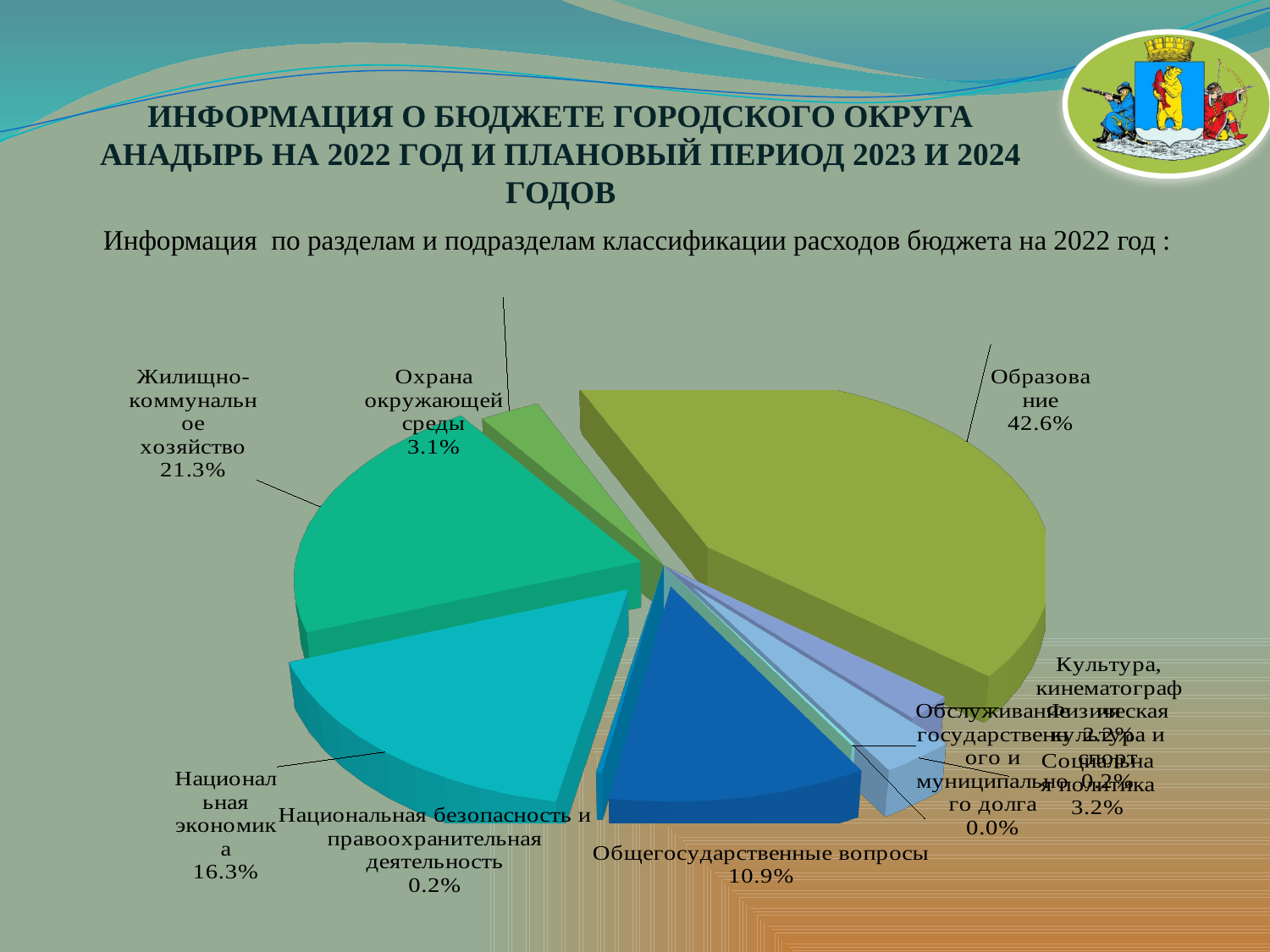
What share of the 2022 budget expenditure does Образование account for? 42.6% What percentage is shown for Жилищно-коммунальное хозяйство? 21.3% What percentage is shown for Национальная экономика? 16.3% What percentage is shown for Национальная безопасность и правоохранительная деятельность? 0.2% By how many percentage points does Образование exceed Жилищно-коммунальное хозяйство? 21.3 What kind of chart is shown on the slide? Pie chart Which section has the largest share of the budget expenditure? Образование Which section has the smallest share of the budget expenditure? Обслуживание государственного и муниципального долга Which is larger: the share for Национальная экономика or for Общегосударственные вопросы? Национальная экономика What percentage is shown for Охрана окружающей среды? 3.1% What percentage is shown for Общегосударственные вопросы? 10.9% Which year's budget expenditure does the chart describe? 2022